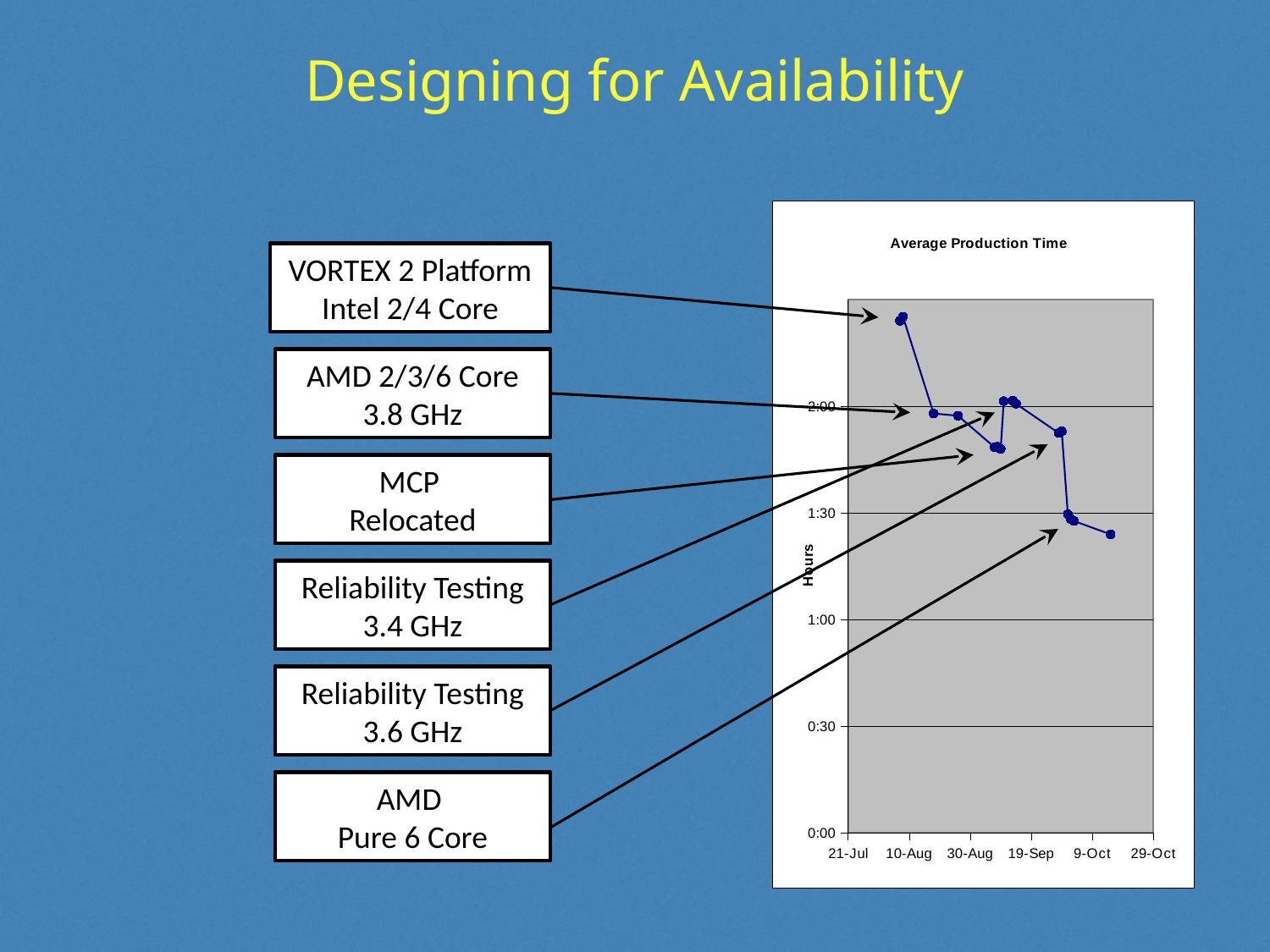
What type of chart is shown on the slide? line chart Which point has the highest value in the chart, the first point or the last point? the first point Where along the x axis does the lowest value in the chart occur? after 9-Oct, at the rightmost point Is the value of the point plotted just before 9-Oct greater or less than 2:00? less What is the label on the vertical axis of the chart? Hours Where along the x axis does the highest value in the chart occur? near 10-Aug What is the title of the chart? Average Production Time Is the value of the last point in the chart greater or less than 1:00? greater Is the value of the last (rightmost) point in the chart greater or less than 1:30? less How many date labels are shown on the x axis of the chart? 6 Do the values in the Average Production Time chart generally rise or fall from left to right? fall